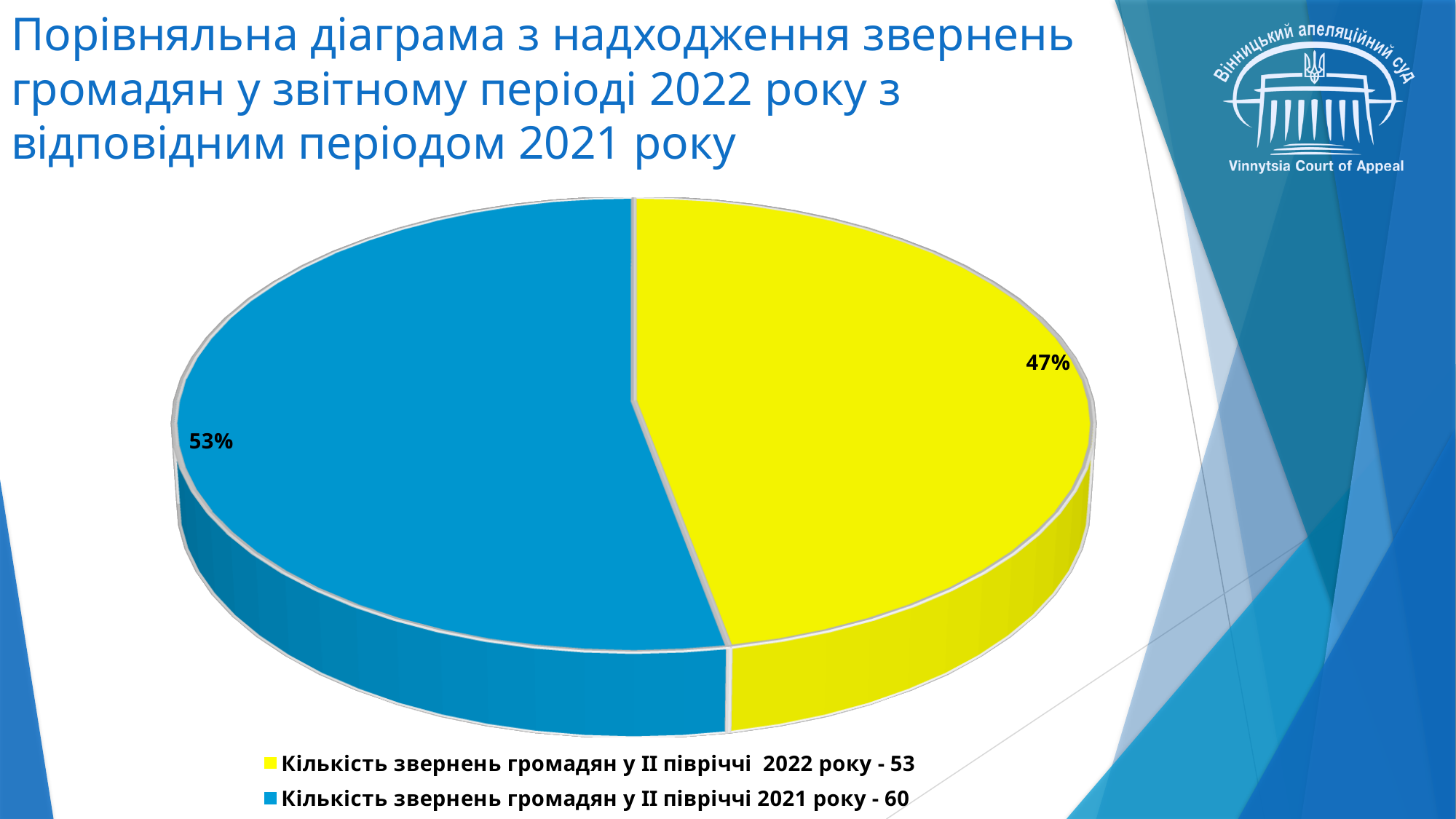
What is the difference in percentage points between the 2021 slice and the 2022 slice? 6 How many slices does the pie chart have? 2 What kind of chart is shown on the slide? pie chart According to the legend, how many citizen appeals were received in the second half of 2022? 53 What percentage share is shown for the blue slice (appeals in the second half of 2021)? 53% According to the legend, how many citizen appeals were received in the second half of 2021? 60 What is the difference between the number of appeals in the second half of 2021 and the second half of 2022, as given in the legend? 7 Which period has the larger share of the pie, the second half of 2022 or the second half of 2021? second half of 2021 What percentage share is shown for the yellow slice (appeals in the second half of 2022)? 47% Which colour represents the appeals received in the second half of 2022? yellow Which slice is the smallest in the pie chart? second half of 2022 (47%) How many entries does the legend list? 2